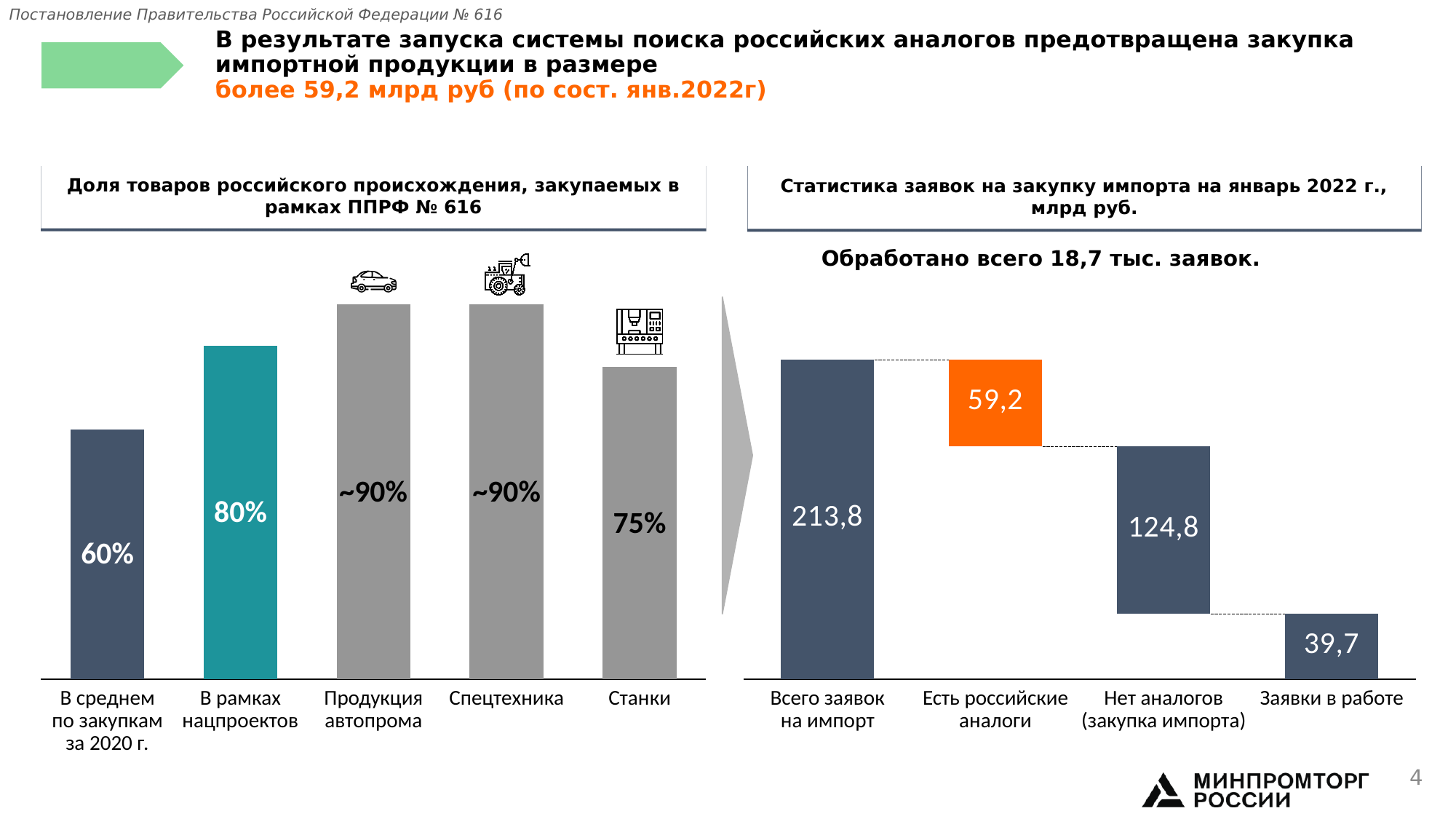
In the left chart, how many categories are shown? 5 In the right chart, what is the value for 'Есть российские аналоги'? 59,2 In the left chart, what is the value for 'Станки'? 75% In the left chart, what is the value for 'В рамках нацпроектов'? 80% In the left chart (Доля товаров российского происхождения), what is the value for 'В среднем по закупкам за 2020 г.'? 60% In the left chart, which category has the lowest value? В среднем по закупкам за 2020 г. In the right chart, which category has the highest value? Всего заявок на импорт What kind of chart is the left chart? Bar chart In the right chart (Статистика заявок на закупку импорта), what is the value for 'Всего заявок на импорт'? 213,8 In the right chart, what is the value for 'Заявки в работе'? 39,7 In the left chart, what is the difference between 'В рамках нацпроектов' and 'В среднем по закупкам за 2020 г.'? 20% In the right chart, what is the difference between 'Нет аналогов (закупка импорта)' and 'Заявки в работе'? 85,1